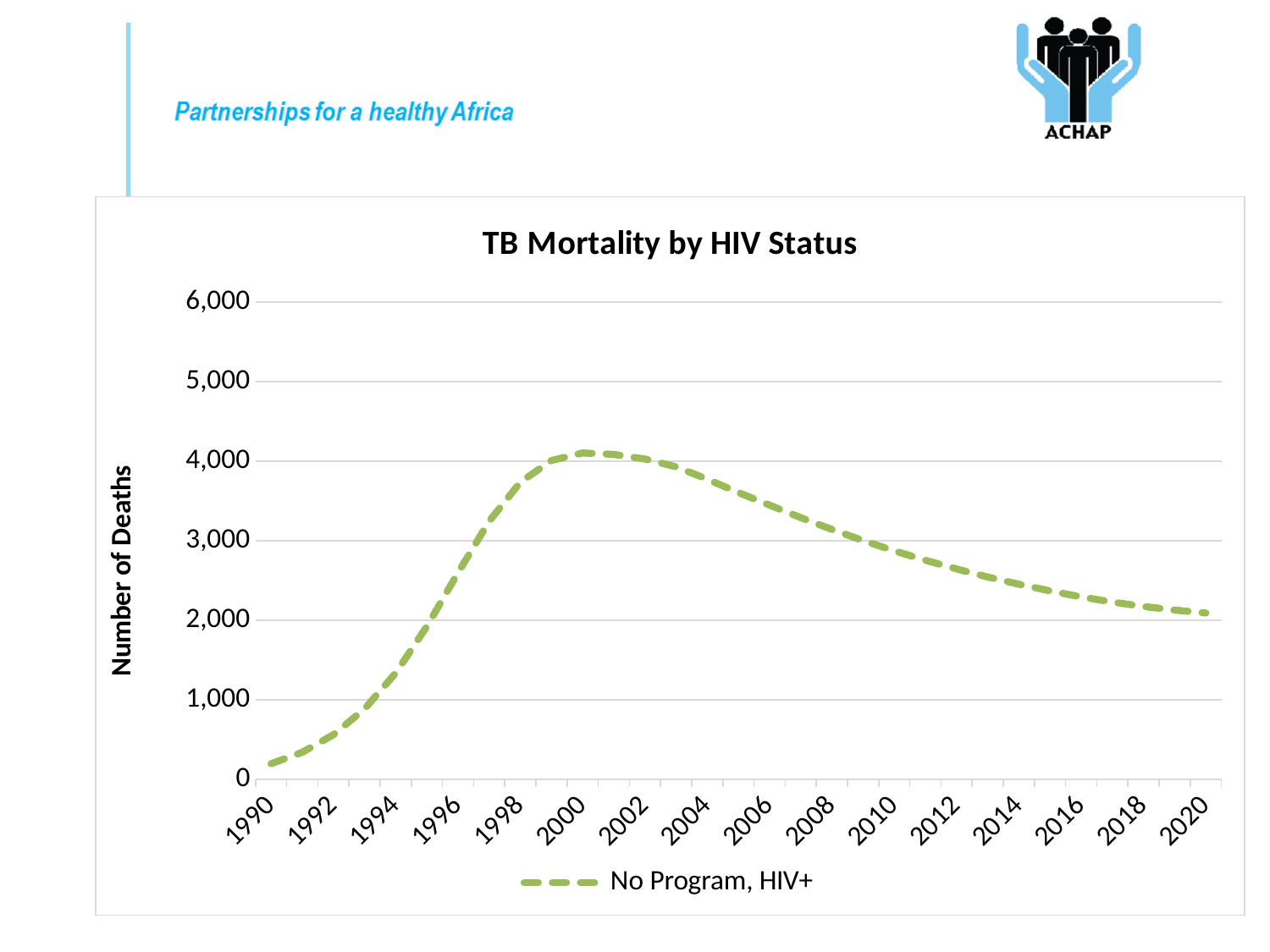
How do the values change from 2002 to 2020? They fall Which is larger, the value for 2000 or the value for 2020? 2000 What kind of chart is shown on the slide? Line chart How many year labels are shown on the x axis? 16 Which year has the lowest number of deaths on the chart? 1990 Is the value for 2006 greater or less than 3,000? greater Is the value for 1990 greater or less than 1,000? less What is the title of the chart? TB Mortality by HIV Status Is the value for 1996 greater or less than 3,000? less How many series does the legend list? 1 What is the name of the series shown in the legend? No Program, HIV+